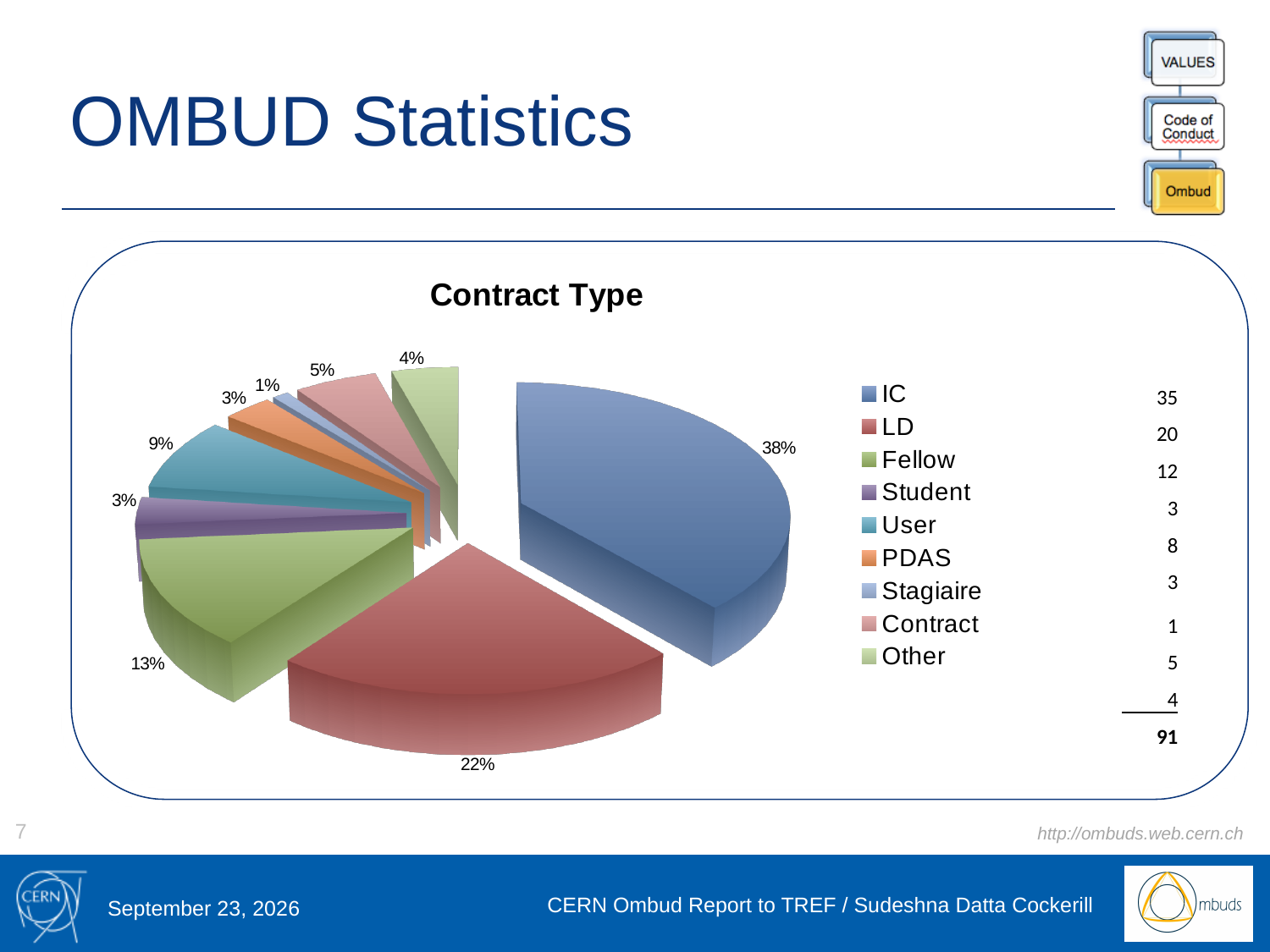
What share of the pie does IC represent? 38% Which category has the smallest slice of the pie? Stagiaire What kind of chart is shown on the slide? pie chart How many categories does the legend of the Contract Type pie chart list? 9 What share of the pie does LD represent? 22% Which category has the largest slice of the pie? IC Which slice is larger, Contract or Other? Contract What is the difference in percentage points between the IC slice and the LD slice? 16% What share of the pie does User represent? 9% What is the title of the chart? Contract Type